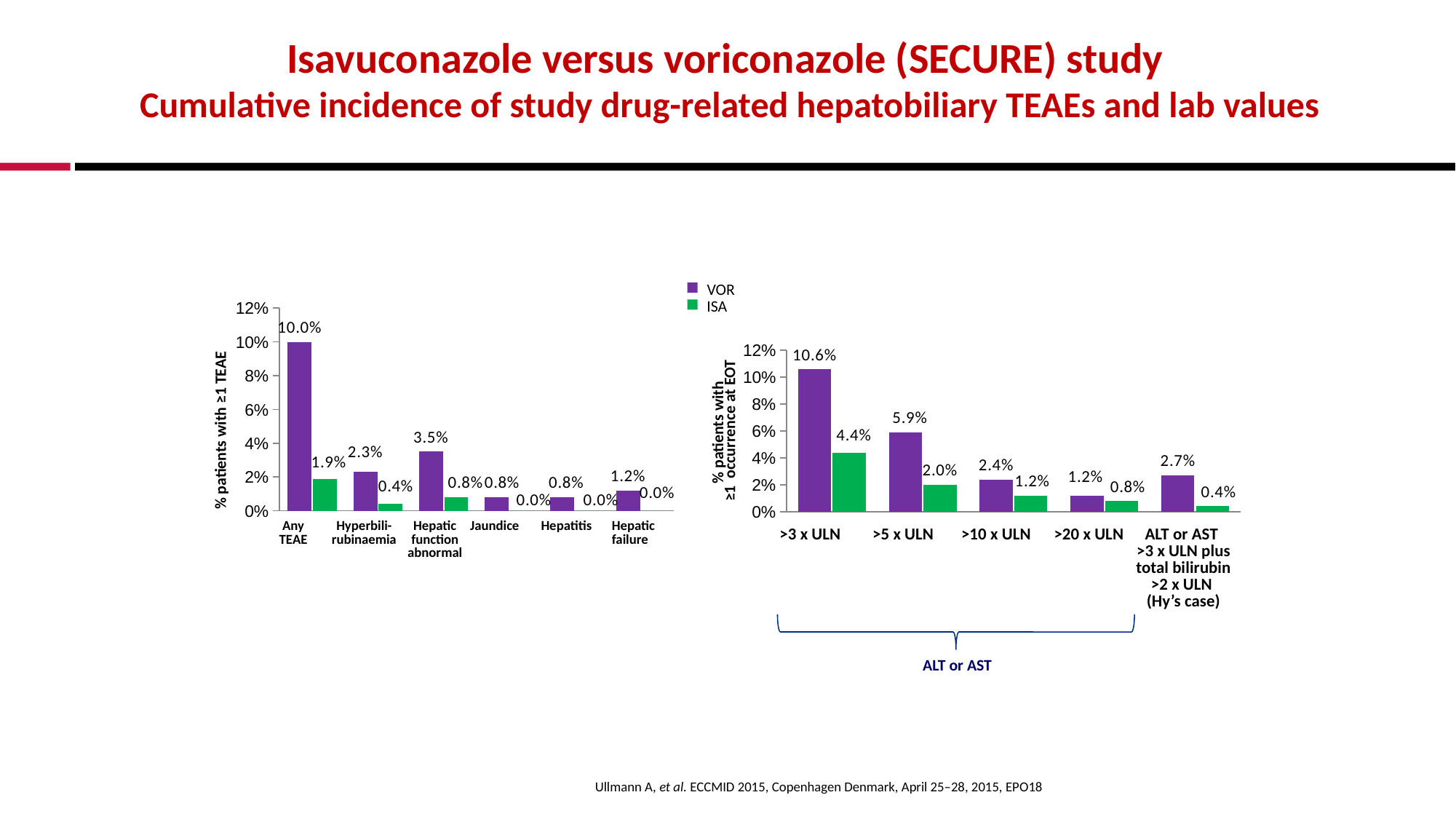
How many categories are shown on the x axis of the right chart (% patients with ≥1 occurrence at EOT)? 5 In the left chart (% patients with ≥1 TEAE), what is the VOR value for Any TEAE? 10.0% How many series does the legend list? 2 In the left chart (% patients with ≥1 TEAE), what is the ISA value for Hepatic function abnormal? 0.8% In the left chart (% patients with ≥1 TEAE), which category has the highest VOR value? Any TEAE In the right chart (% patients with ≥1 occurrence at EOT), what is the ISA value for >5 x ULN? 2.0% In the left chart (% patients with ≥1 TEAE), what is the difference between the VOR and ISA values for Hyperbilirubinaemia? 1.9% In the right chart (% patients with ≥1 occurrence at EOT), what is the VOR value for >3 x ULN? 10.6% In the right chart (% patients with ≥1 occurrence at EOT), what is the difference between the VOR and ISA values for >3 x ULN? 6.2% In the right chart (% patients with ≥1 occurrence at EOT), which category has the lowest ISA value? ALT or AST >3 x ULN plus total bilirubin >2 x ULN (Hy's case) In the left chart (% patients with ≥1 TEAE), which is larger for Hepatic function abnormal: the VOR value or the ISA value? VOR What kind of chart is the left chart (% patients with ≥1 TEAE)? Bar chart